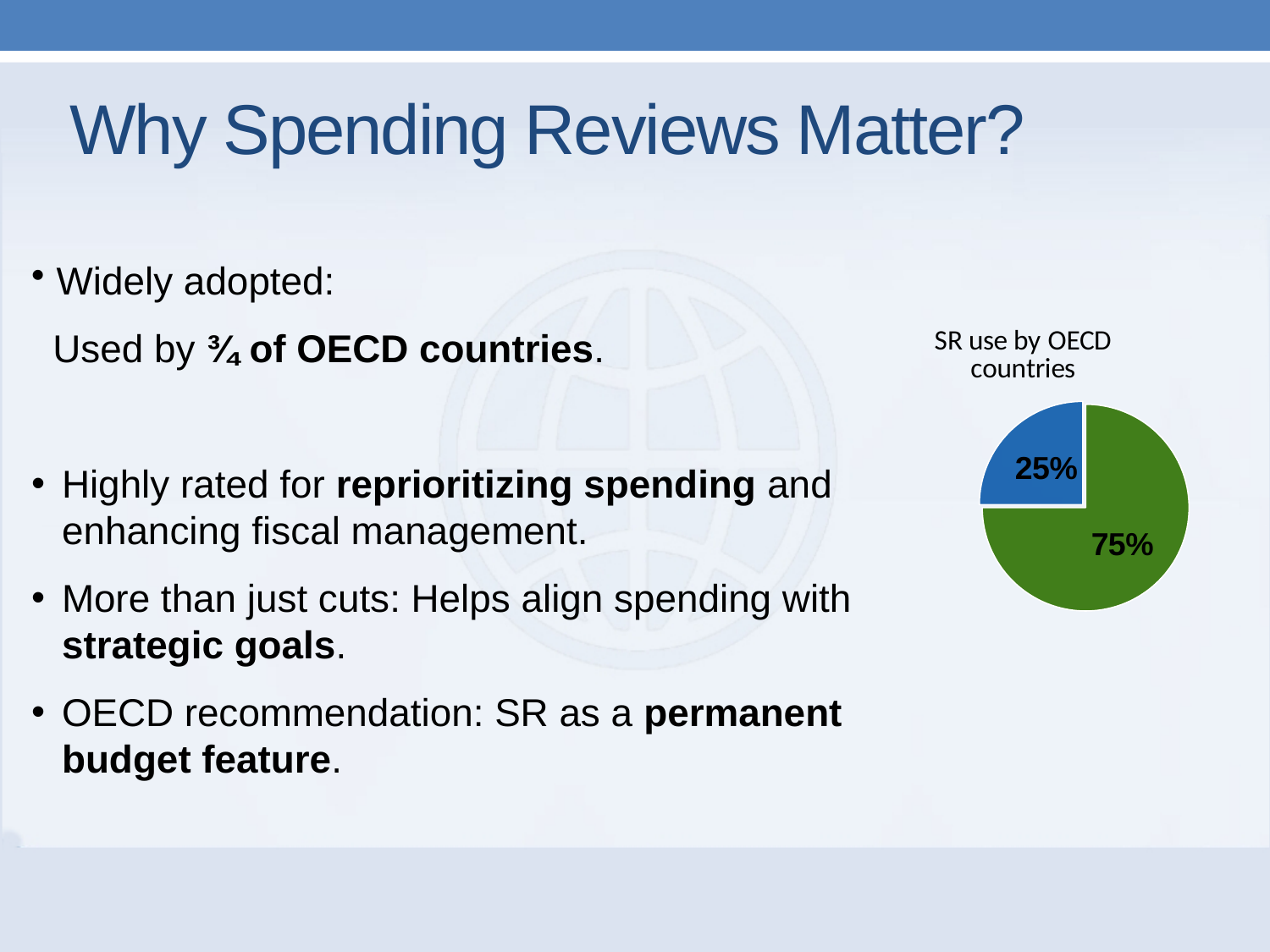
What kind of chart is shown on the slide? Pie chart How many slices does the pie chart have? 2 What do the two slices of the pie chart add up to? 100% Which slice of the pie chart is the smallest? The blue slice (25%) What is the title of the pie chart? SR use by OECD countries Which slice of the pie chart is the largest? The green slice (75%) What share of the pie does the blue slice represent? 25% What share of the pie does the green slice represent? 75% By how many percentage points does the green slice exceed the blue slice? 50 percentage points What colour is the slice labelled 25%? Blue Which is larger, the green slice or the blue slice? The green slice